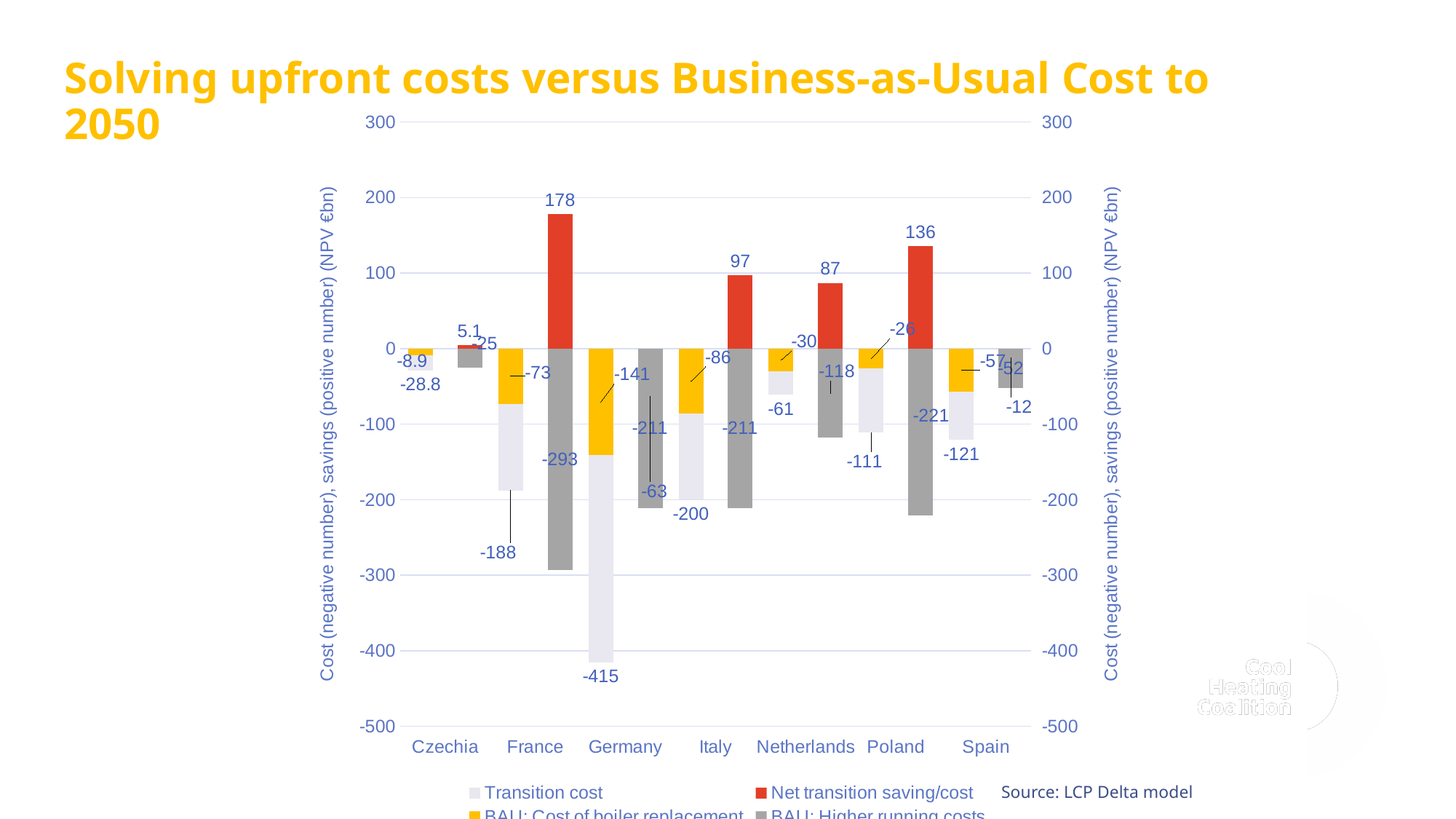
Which country has the highest Net transition saving/cost value? France What is the difference between the Net transition saving/cost values for France and Poland? 42 How many series does the chart's legend list? 4 What is the Net transition saving/cost value for France? 178 What is the Transition cost value for Czechia? -28.8 What is the BAU: Higher running costs value for Poland? -221 What kind of chart is shown on the slide? bar chart What is the Transition cost value for Germany? -415 What source is cited for the chart's data? LCP Delta model How many countries are shown on the x axis of the chart? 7 Which has the larger Net transition saving/cost value, Italy or Netherlands? Italy What is the BAU: Cost of boiler replacement value for Italy? -86